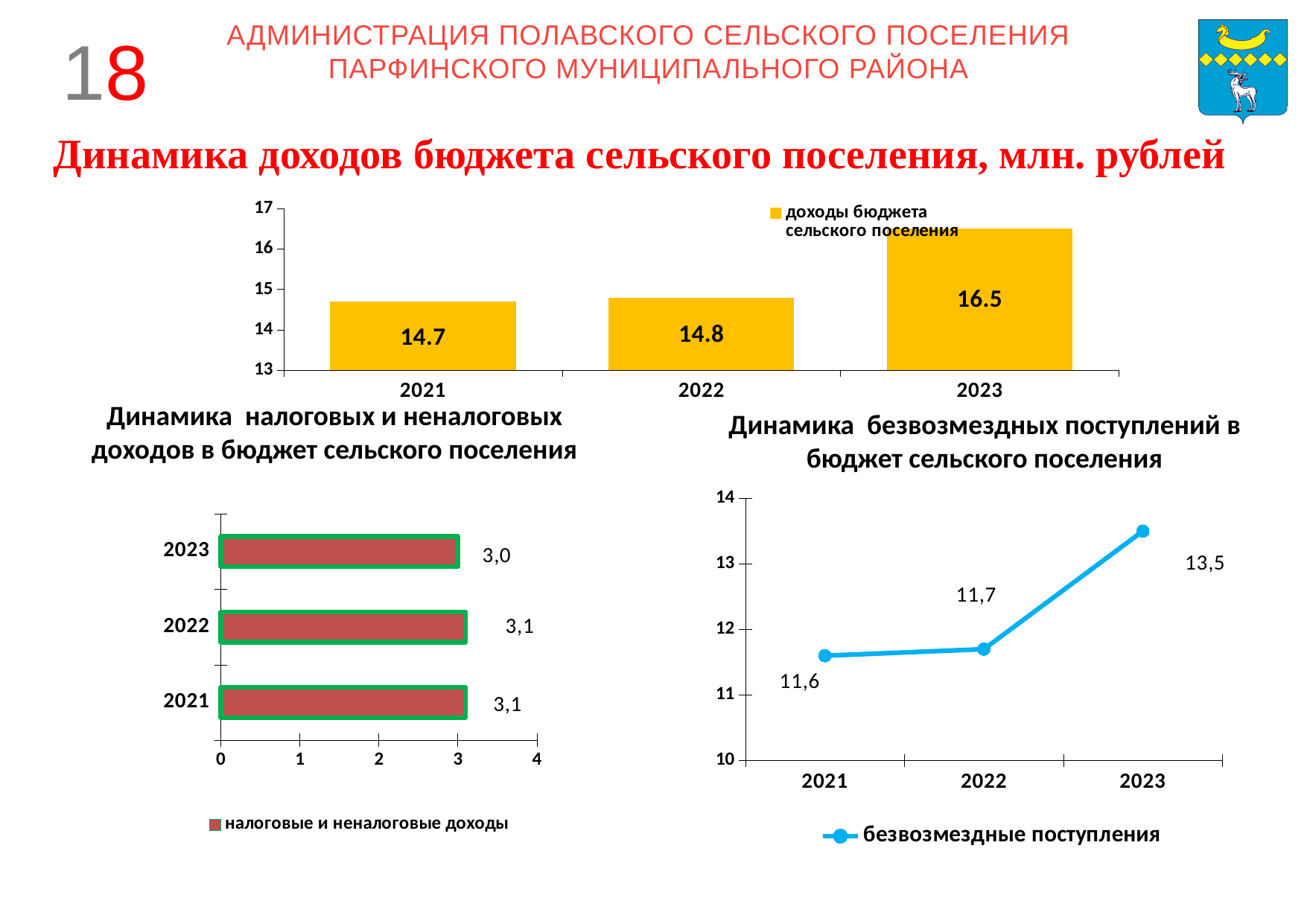
In the bottom-right chart 'Динамика безвозмездных поступлений в бюджет сельского поселения', which year has the highest value? 2023 What type of chart is the bottom-right chart 'Динамика безвозмездных поступлений в бюджет сельского поселения'? line chart In the bottom-left chart 'Динамика налоговых и неналоговых доходов в бюджет сельского поселения', how many years are shown? 3 In the top chart 'Динамика доходов бюджета сельского поселения, млн. рублей', what is the value for 2023? 16.5 What is the legend entry of the bottom-right chart 'Динамика безвозмездных поступлений в бюджет сельского поселения'? безвозмездные поступления In the bottom-right chart 'Динамика безвозмездных поступлений в бюджет сельского поселения', what is the value for 2022? 11,7 In the top chart 'Динамика доходов бюджета сельского поселения, млн. рублей', do the values rise or fall from 2021 to 2023? rise In the bottom-left chart 'Динамика налоговых и неналоговых доходов в бюджет сельского поселения', what is the value for 2023? 3,0 In the top chart 'Динамика доходов бюджета сельского поселения, млн. рублей', what is the difference between the 2023 and 2021 values? 1.8 In the bottom-left chart 'Динамика налоговых и неналоговых доходов в бюджет сельского поселения', is the value for 2022 greater or less than 2? greater In the top chart 'Динамика доходов бюджета сельского поселения, млн. рублей', which year has the lowest value? 2021 What type of chart is the top chart 'Динамика доходов бюджета сельского поселения, млн. рублей'? bar chart